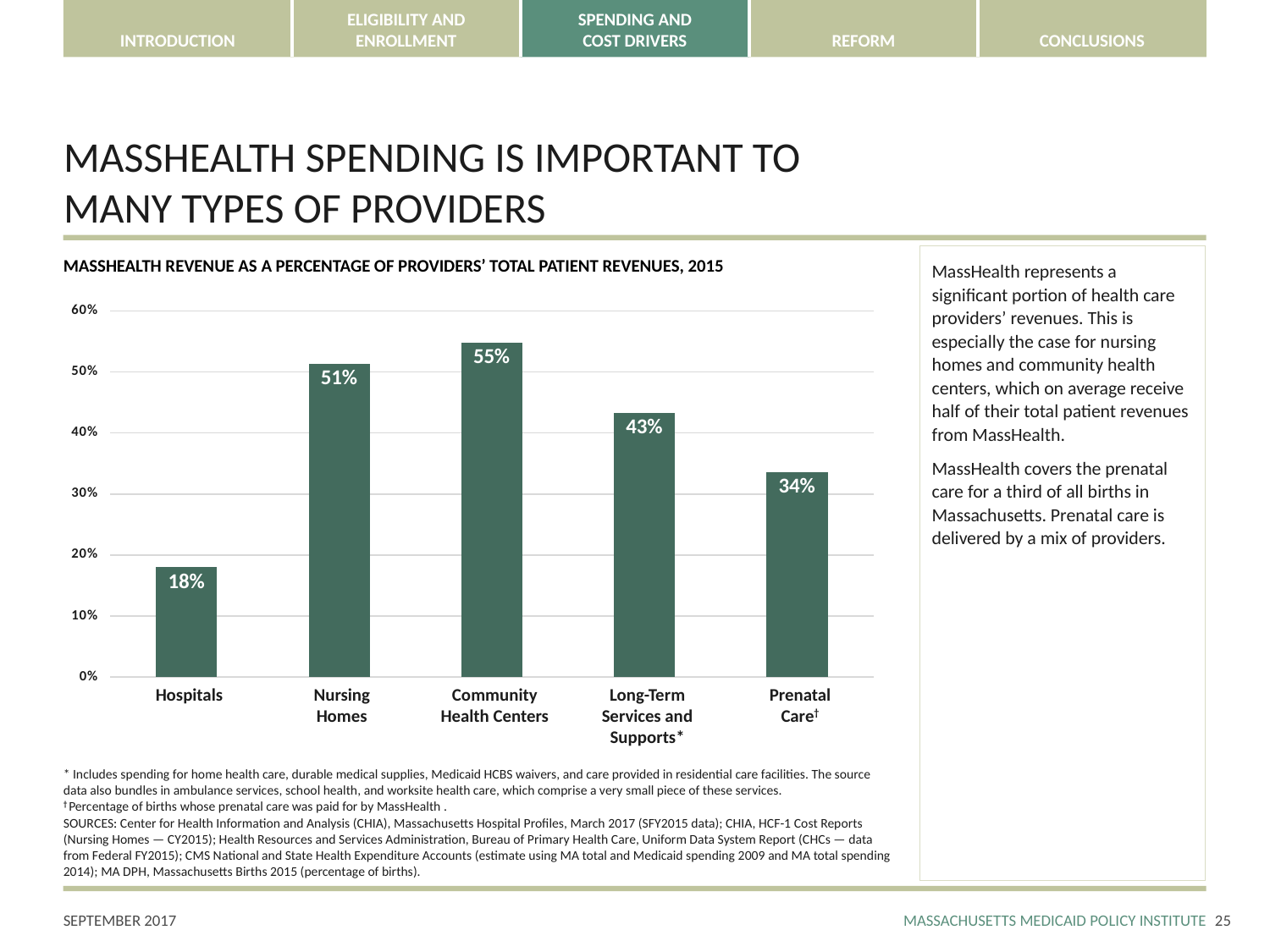
What is the MassHealth revenue percentage for Nursing Homes? 51% Is the value for Prenatal Care greater or less than 30%? greater What is the title of the chart? MassHealth Revenue as a Percentage of Providers' Total Patient Revenues, 2015 Which provider type has the lowest MassHealth revenue percentage? Hospitals What is the MassHealth revenue percentage for Hospitals? 18% Which is larger, the percentage for Nursing Homes or for Long-Term Services and Supports? Nursing Homes Which provider type has the highest MassHealth revenue percentage? Community Health Centers What is the MassHealth revenue percentage for Prenatal Care? 34% What is the difference between the percentages for Community Health Centers and Hospitals? 37% What kind of chart is shown on the slide? Bar chart How many provider categories are shown in the chart? 5 What is the MassHealth revenue percentage for Long-Term Services and Supports? 43%